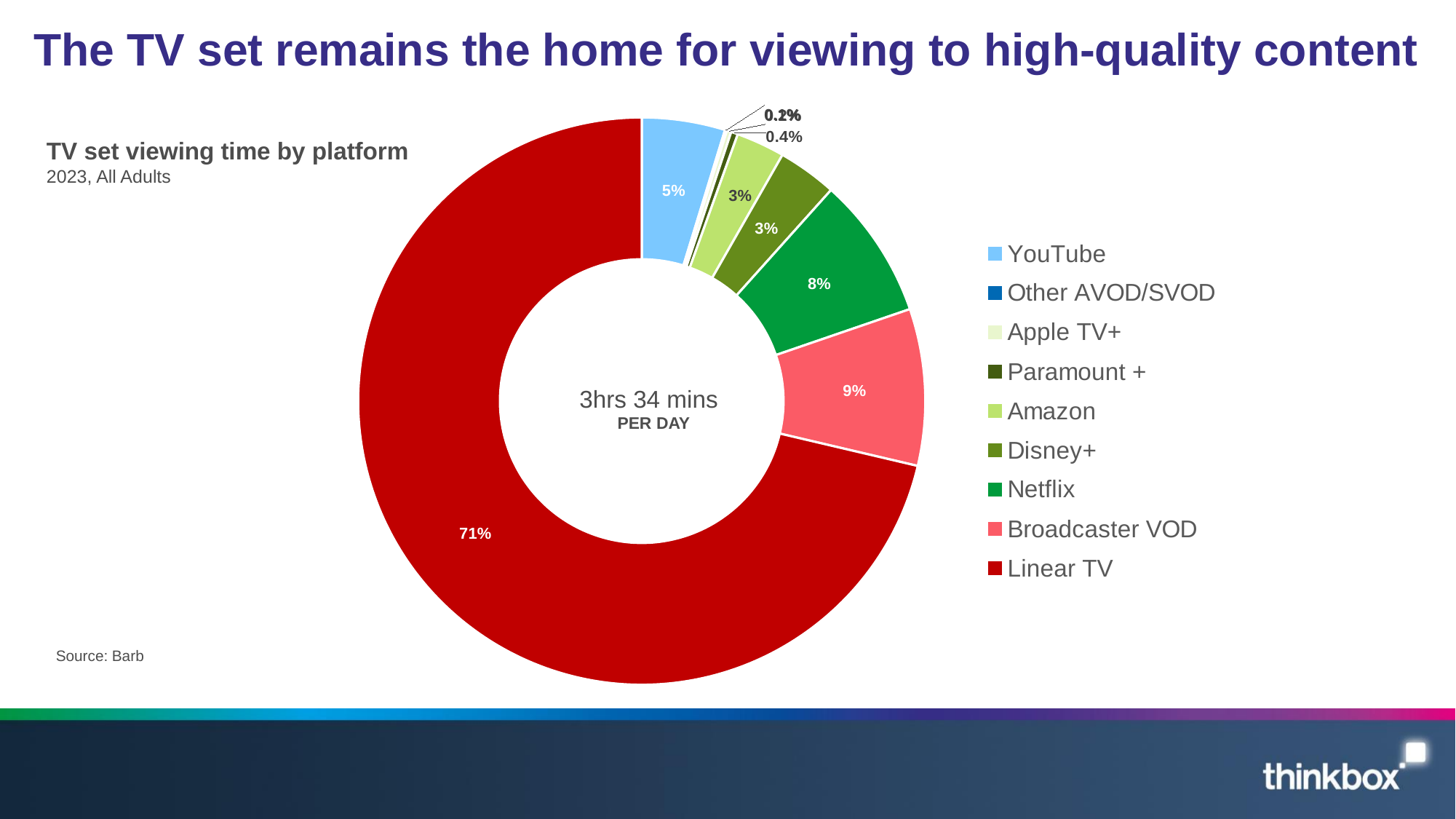
What is the difference in percentage points between Netflix's share and YouTube's share? 3 percentage points What share of TV set viewing time does Amazon have? 3% What is the share for Netflix in the TV set viewing time chart? 8% What total daily viewing time is shown in the centre of the chart? 3hrs 34 mins per day What percentage of TV set viewing time goes to YouTube? 5% What share of TV set viewing time does Linear TV account for? 71% What type of chart is used to show TV set viewing time by platform? Doughnut chart Which is larger, the share for Netflix or the share for Broadcaster VOD? Broadcaster VOD What percentage of TV set viewing time is Broadcaster VOD? 9% How many percentage points larger is Linear TV's share than Broadcaster VOD's share? 62 percentage points How many platforms are listed in the chart's legend? 9 Which platform has the largest share of TV set viewing time? Linear TV